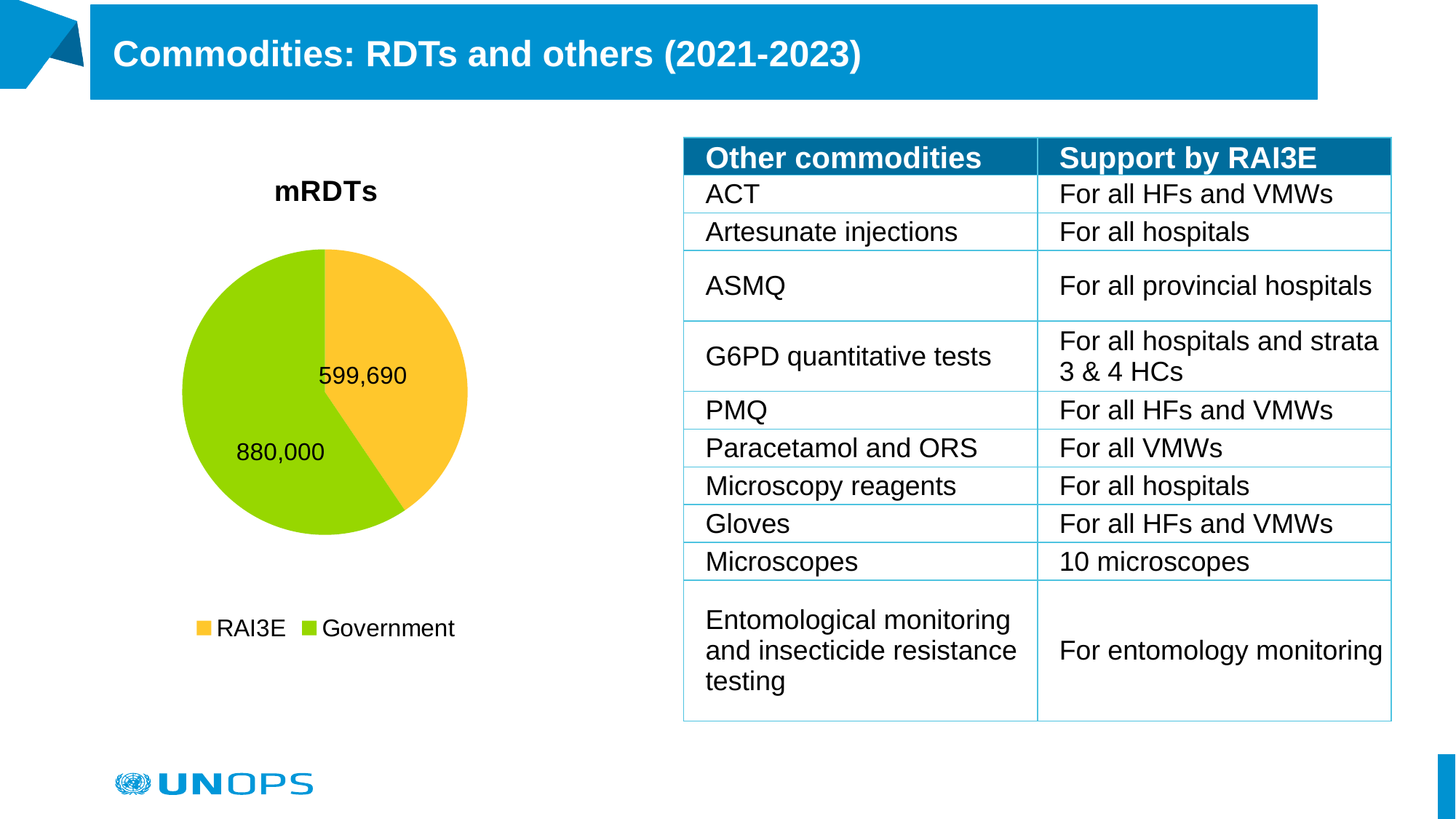
How many slices does the mRDTs pie chart have? 2 In the mRDTs pie chart, which category has the smallest slice? RAI3E In the mRDTs pie chart, what is the difference between the Government value and the RAI3E value? 280,310 In the mRDTs pie chart, which is larger, the RAI3E value or the Government value? Government In the mRDTs pie chart, what is the total of the two slices? 1,479,690 What is the title of the pie chart on the slide? mRDTs In the mRDTs pie chart, what is the value for RAI3E? 599,690 What type of chart is the mRDTs chart? pie chart In the mRDTs pie chart, which category has the largest slice? Government In the mRDTs pie chart, what colour is the Government slice? green How many entries does the legend of the mRDTs pie chart list? 2 In the mRDTs pie chart, what is the value for Government? 880,000